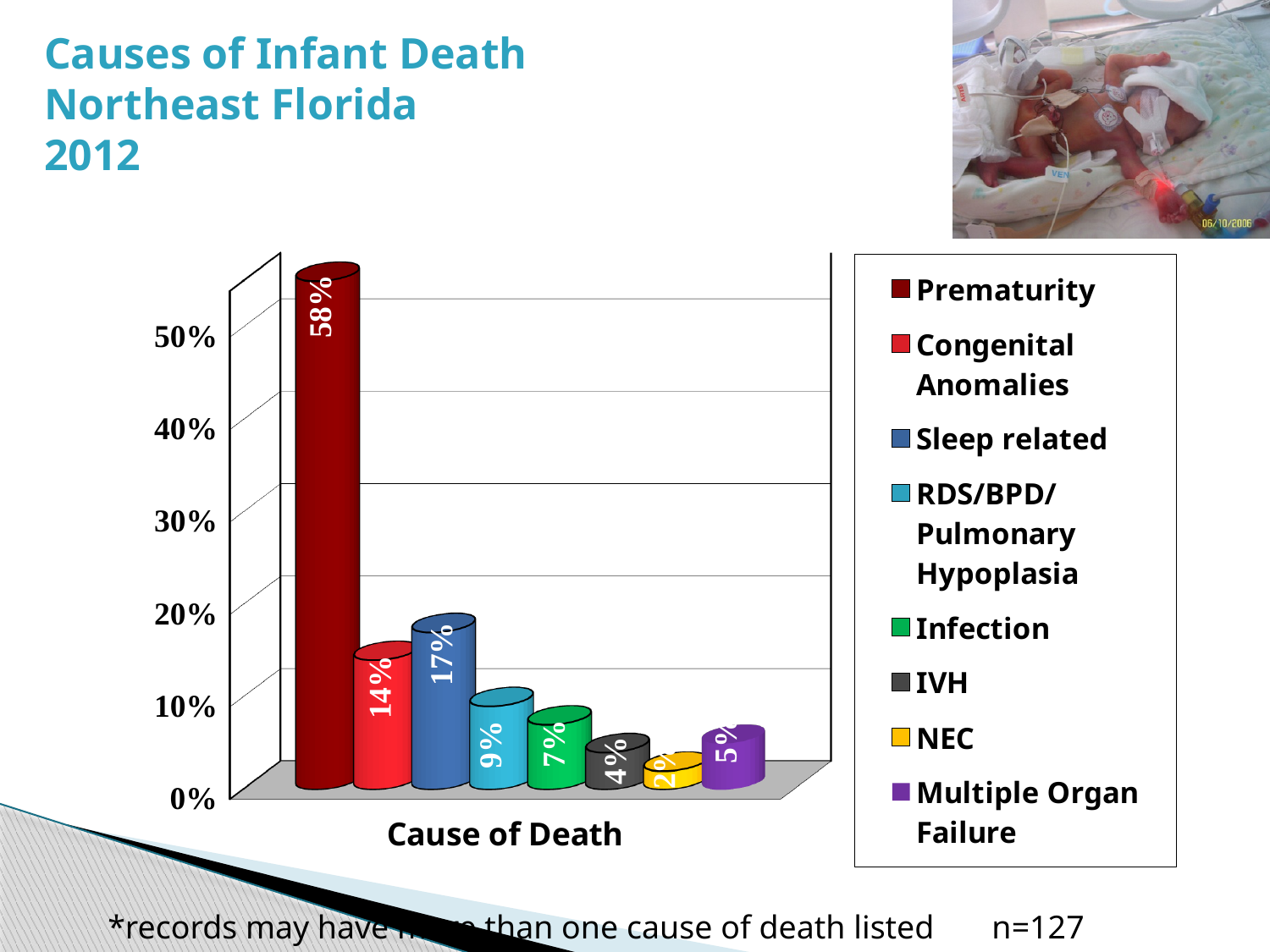
Which cause of death has the highest percentage? Prematurity What is the difference between the Prematurity and Sleep related percentages? 41% What is the value shown for Sleep related deaths? 17% What is the x-axis title of the chart? Cause of Death Which cause of death has the lowest percentage? NEC Which is larger, the value for Congenital Anomalies or the value for Sleep related? Sleep related What percentage is shown for Congenital Anomalies? 14% What kind of chart is shown on the slide? bar chart What percentage of infant deaths is attributed to Prematurity? 58% What is the value for Infection? 7% Is the value for RDS/BPD/Pulmonary Hypoplasia greater or less than 10%? less How many series does the legend list? 8